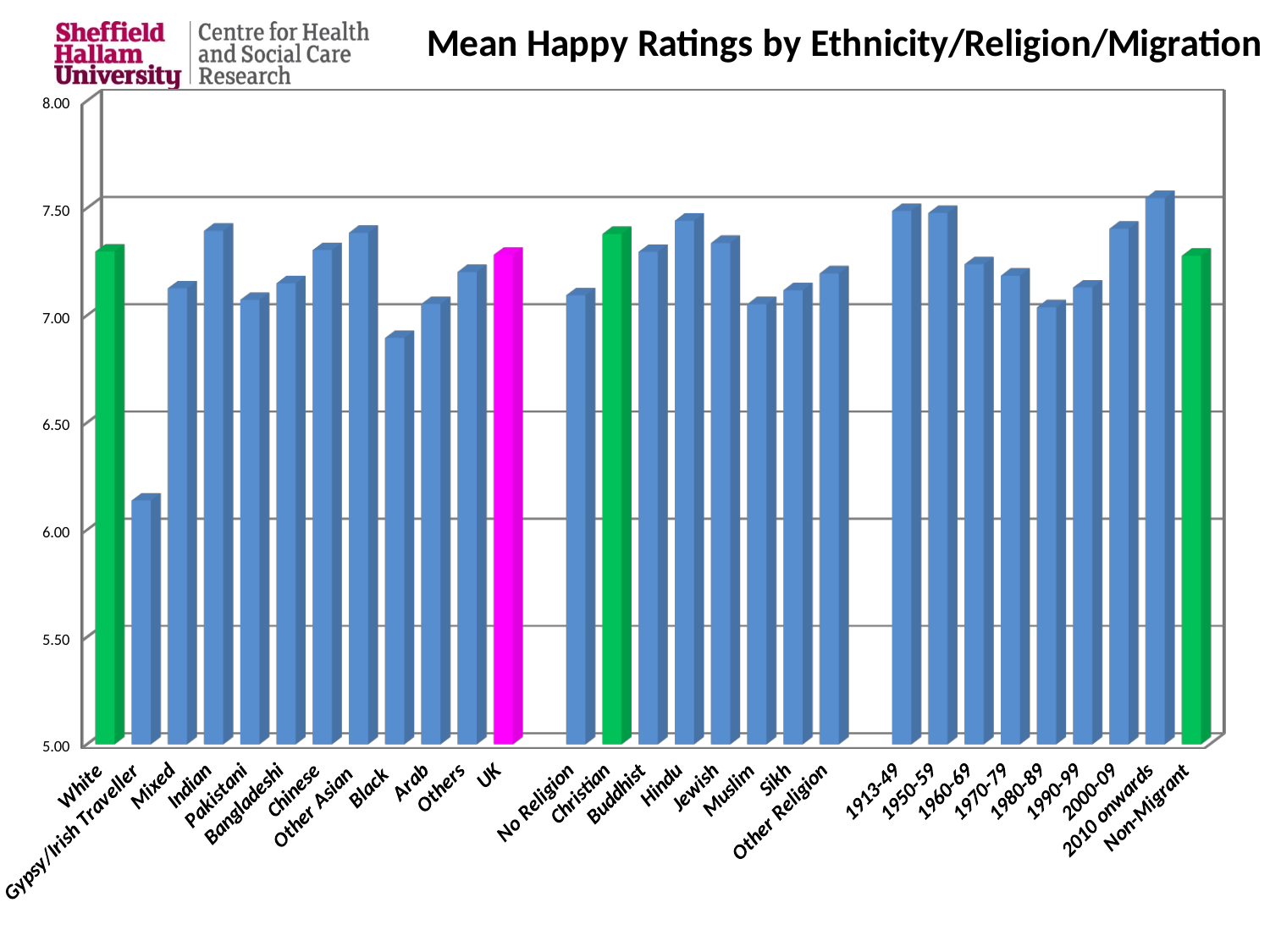
How many bars are plotted on the chart? 29 Which category has the lowest mean happy rating? Gypsy/Irish Traveller Is the value for Indian greater or less than 7.00? greater Is the value for Black greater or less than 7.00? less Which category has the highest mean happy rating? 2010 onwards Is the value for Gypsy/Irish Traveller greater or less than 6.50? less Which has the higher mean happy rating, Hindu or Muslim? Hindu Which has the higher mean happy rating, White or Gypsy/Irish Traveller? White What kind of chart is shown on the slide? Bar chart Which has the higher mean happy rating, 1913-49 or 1980-89? 1913-49 What is the title of the chart? Mean Happy Ratings by Ethnicity/Religion/Migration